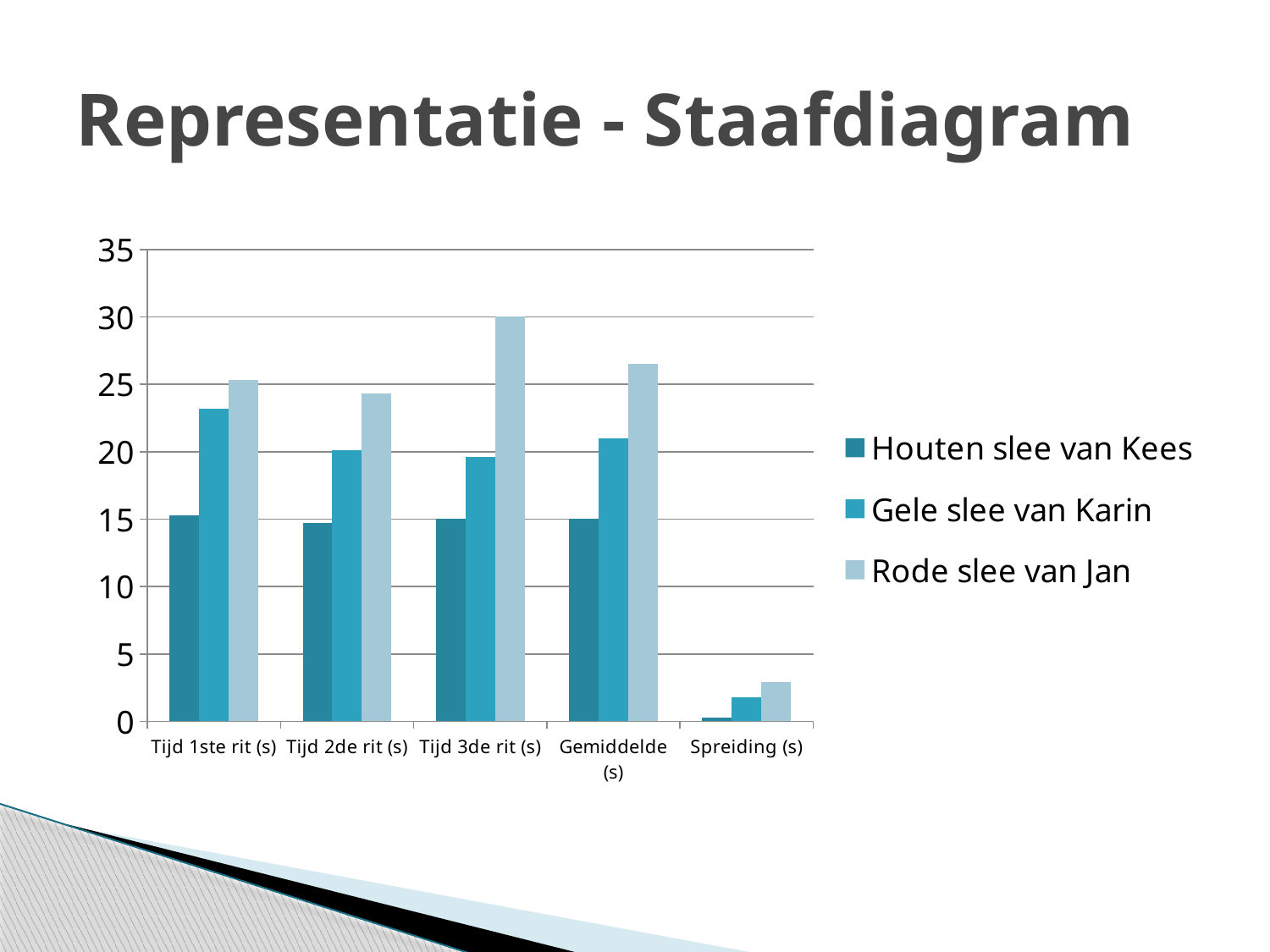
Is the value for Gele slee van Karin at Tijd 1ste rit (s) greater or less than 20? greater How many categories are shown on the x axis? 5 Is the value for Rode slee van Jan at Spreiding (s) greater or less than 5? less Is the value for Houten slee van Kees at Tijd 2de rit (s) greater or less than 20? less At Tijd 1ste rit (s), which is larger: Gele slee van Karin or Houten slee van Kees? Gele slee van Karin What is the title of the slide? Representatie - Staafdiagram How many series does the legend list? 3 For Houten slee van Kees, which category has the lowest value? Spreiding (s) What is the value for Rode slee van Jan at Tijd 3de rit (s)? 30 For Rode slee van Jan, which category has the highest value? Tijd 3de rit (s) What kind of chart is shown on the slide? bar chart Which series has the highest value at Tijd 3de rit (s)? Rode slee van Jan